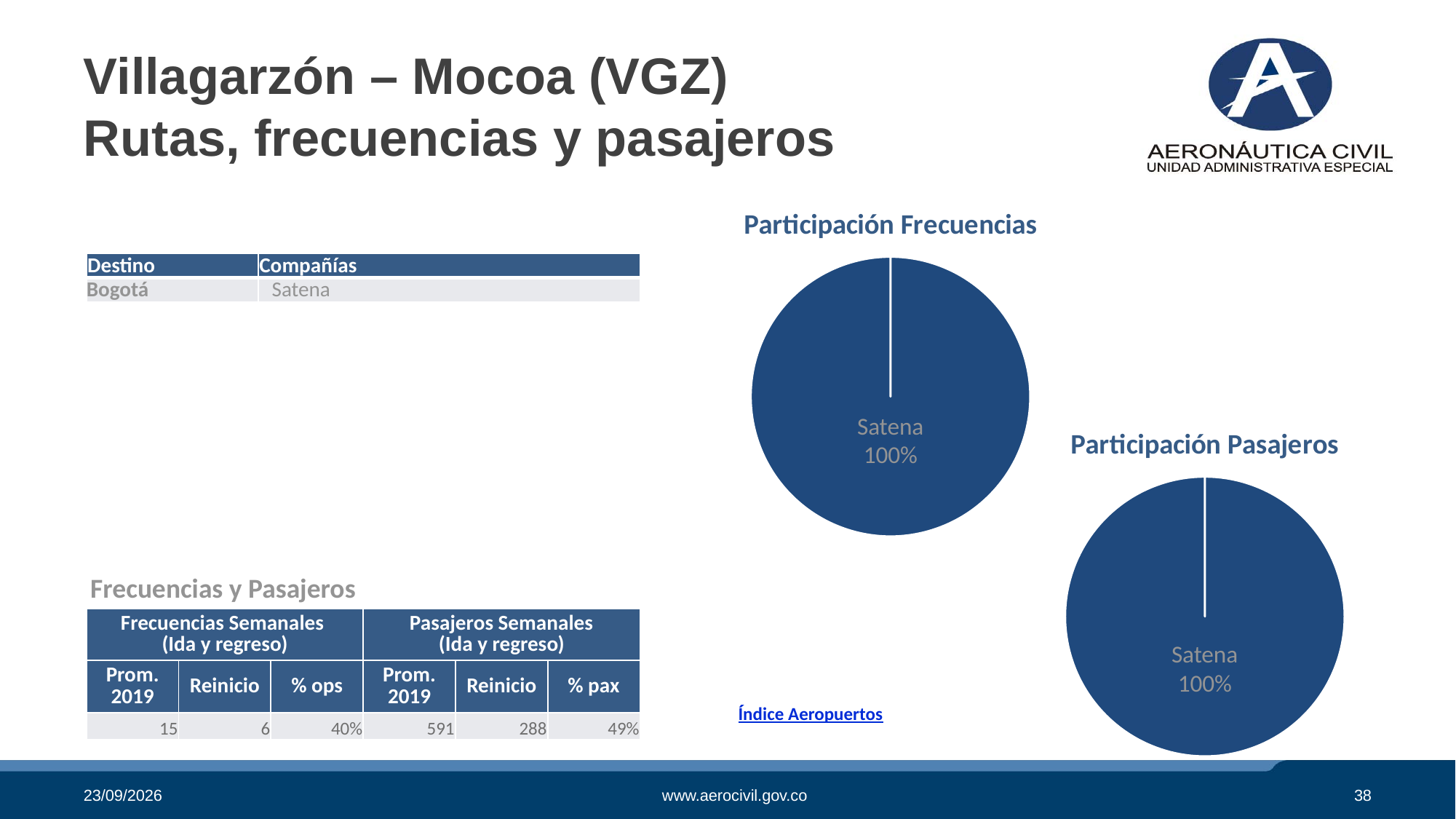
In the 'Participación Frecuencias' chart, what share does Satena have? 100% What is the title of the pie chart in the upper right of the slide? Participación Frecuencias How many pie charts are on the slide? 2 Which company is shown in the 'Participación Pasajeros' pie chart? Satena What kind of chart is 'Participación Frecuencias'? Pie chart How many slices does the 'Participación Pasajeros' pie chart have? 1 What kind of chart is 'Participación Pasajeros'? Pie chart In the 'Participación Pasajeros' chart, what share does Satena have? 100% How many slices does the 'Participación Frecuencias' pie chart have? 1 Which company is shown in the 'Participación Frecuencias' pie chart? Satena What is the title of the pie chart in the lower right of the slide? Participación Pasajeros